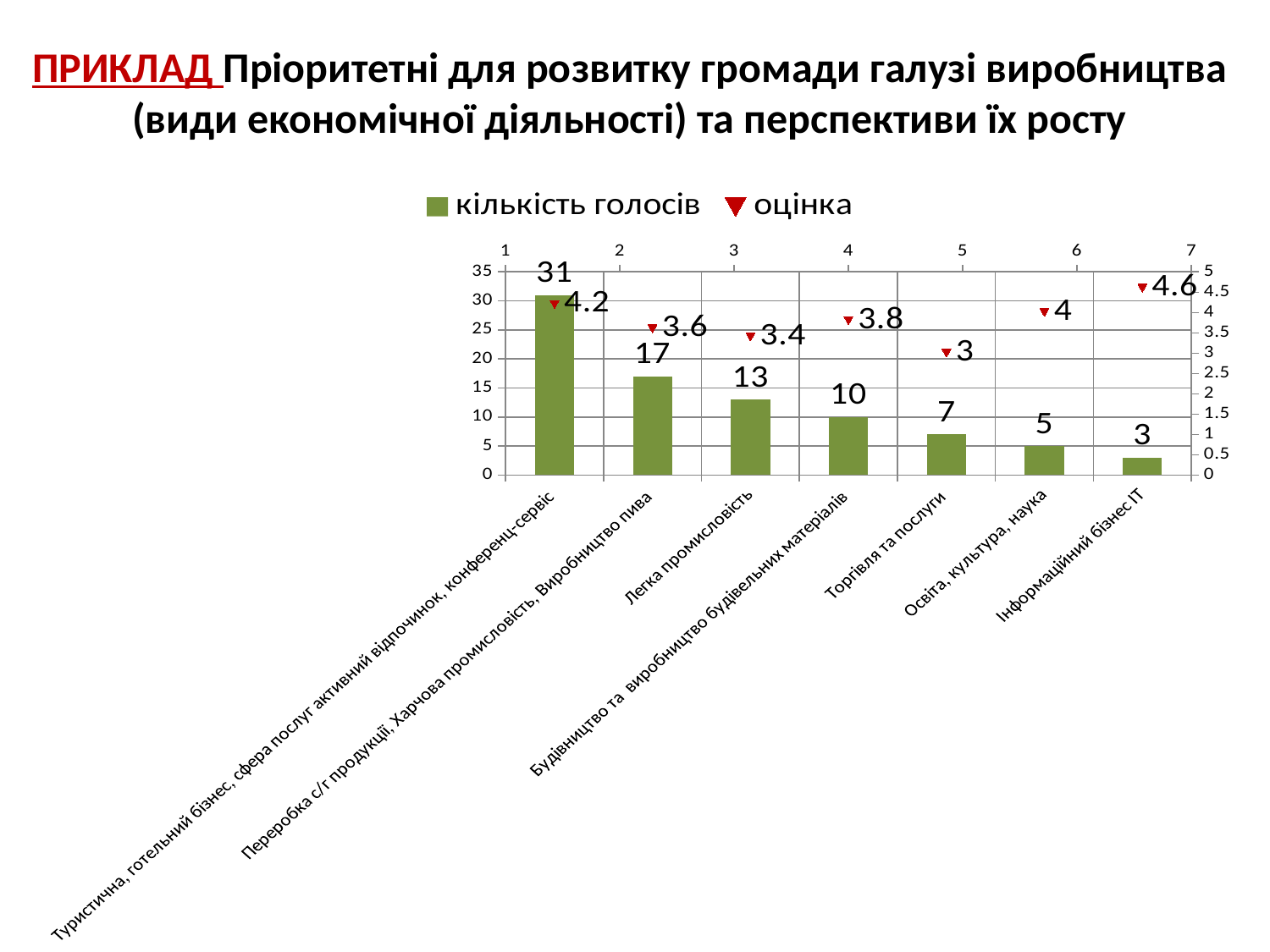
What colour are the bars for кількість голосів? green Which has more votes: Будівництво та виробництво будівельних матеріалів or Торгівля та послуги? Будівництво та виробництво будівельних матеріалів Which category has the highest оцінка value? Інформаційний бізнес ІТ How many series does the chart legend list? 2 What is the оцінка value for Інформаційний бізнес ІТ? 4.6 How many votes (кількість голосів) does Легка промисловість have? 13 Which category has the lowest оцінка value? Торгівля та послуги What is the difference in votes between Переробка с/г продукції, Харчова промисловість, Виробництво пива and Освіта, культура, наука? 12 How many categories are shown on the x axis of the chart? 7 What is the оцінка value for Торгівля та послуги? 3 Which category has the highest number of votes (кількість голосів)? Туристична, готельний бізнес, сфера послуг активний відпочинок, конференц-сервіс Do the кількість голосів values rise or fall from left to right along the x axis? fall